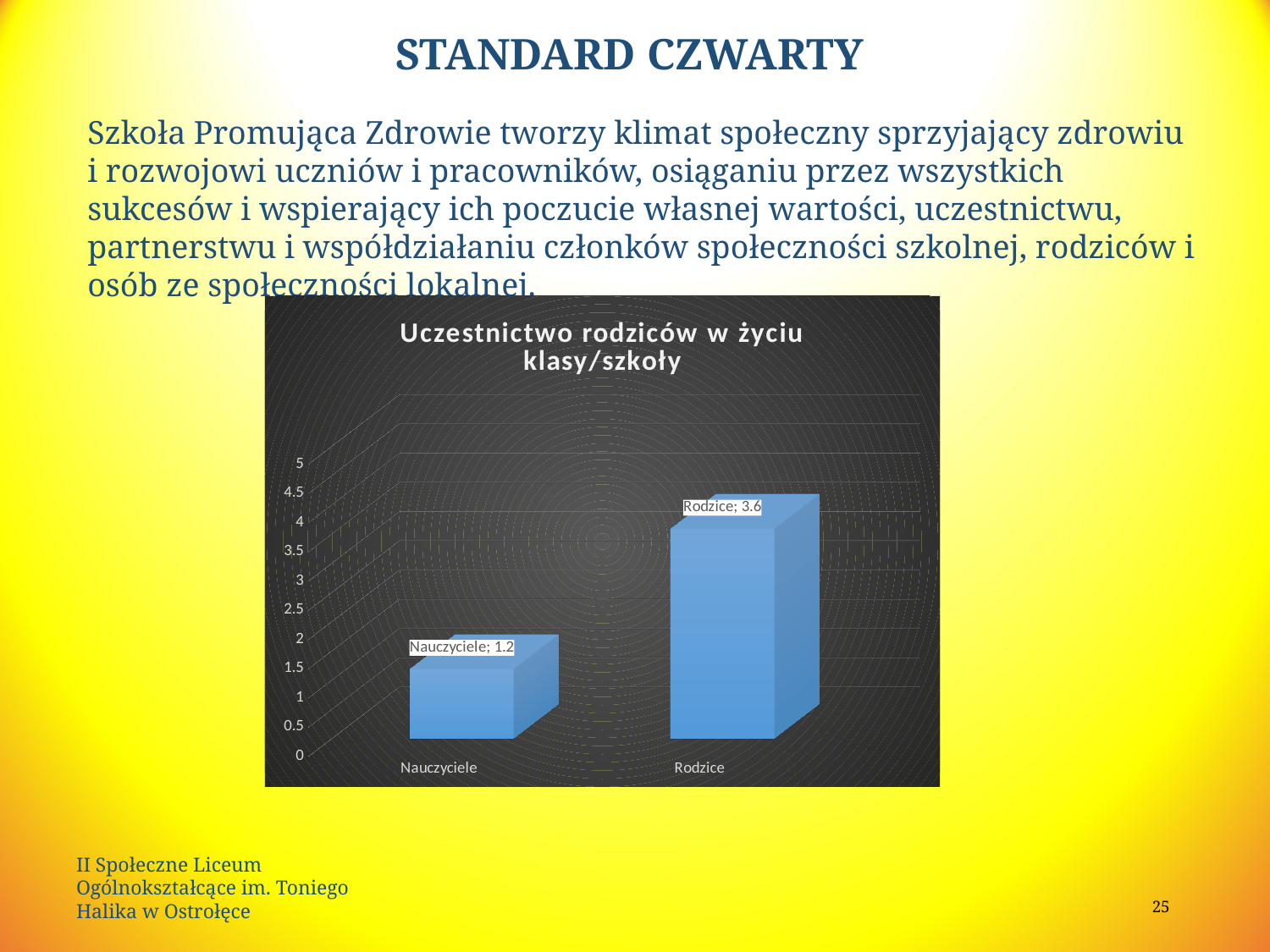
What is the value for Nauczyciele in the chart? 1.2 What kind of chart is shown on the slide? bar chart What is the value for Rodzice in the chart? 3.6 Which is larger, the value for Nauczyciele or the value for Rodzice? Rodzice Which category has the lowest value? Nauczyciele What is the maximum value shown on the vertical axis of the chart? 5 Which category has the highest value? Rodzice How many categories are shown in the chart? 2 What is the title of the chart? Uczestnictwo rodziców w życiu klasy/szkoły Is the value for Rodzice greater or less than 3? greater What is the difference between the values for Rodzice and Nauczyciele? 2.4 Is the value for Nauczyciele greater or less than 2? less